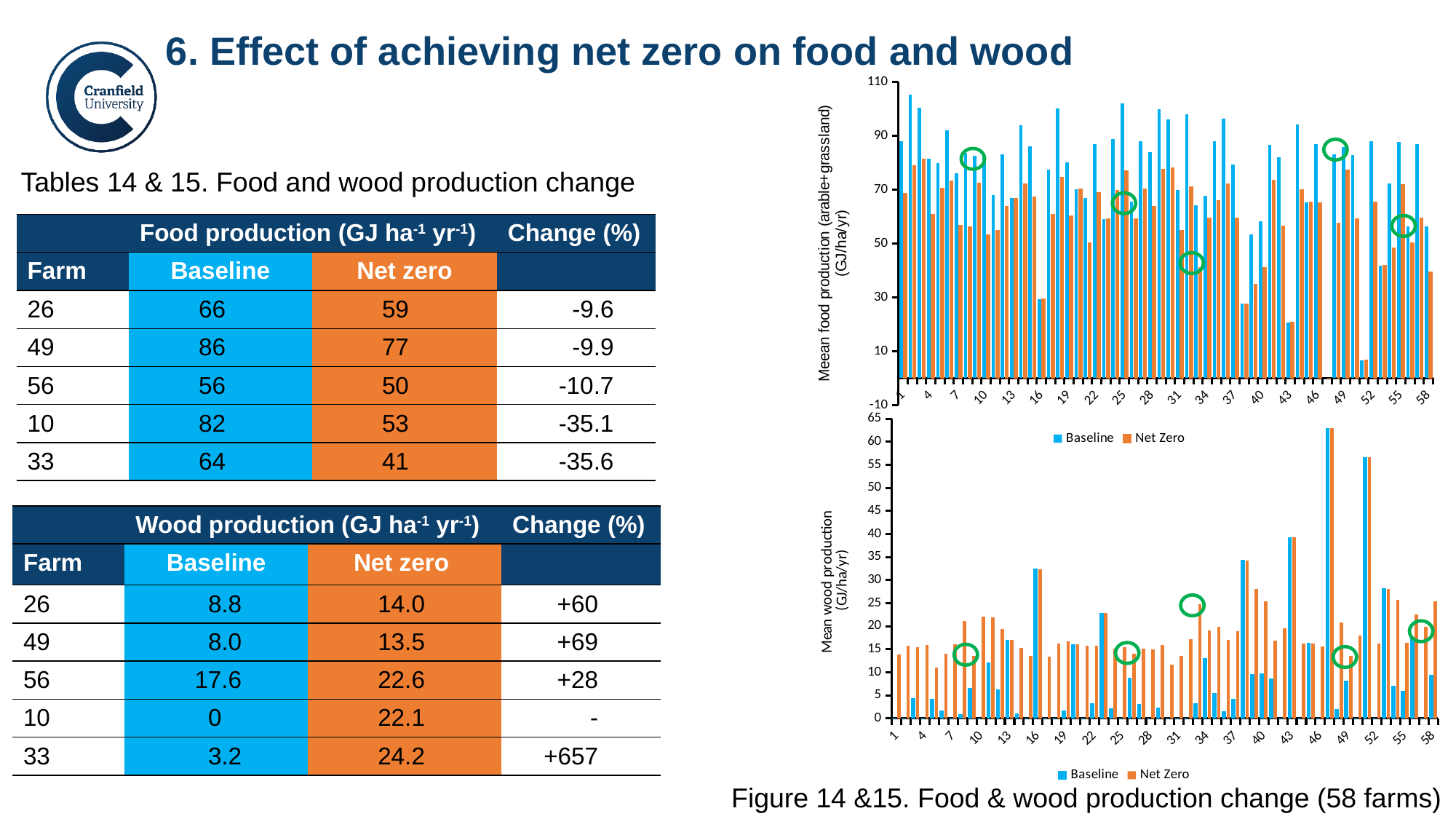
In the bottom chart (mean wood production), is the Baseline value for farm 47 greater or less than 50? greater What kind of chart is the top chart (mean food production)? bar chart In the top chart (mean food production), is the Baseline value for farm 1 greater or less than 70? greater In the top chart (mean food production), is the Net Zero value for farm 16 greater or less than 50? less What are the two legend entries of the top chart (mean food production)? Baseline and Net Zero In the bottom chart (mean wood production), which is larger, the Baseline value for farm 47 or the Baseline value for farm 52? farm 47 How many series does the legend of the bottom chart (mean wood production) list? 2 In the bottom chart (mean wood production), which farm has the highest Baseline value? 47 According to the figure caption, how many farms are plotted in the charts? 58 In the top chart (mean food production), which is larger for farm 16, the Baseline or the Net Zero value? Neither; they are equal What is the y-axis title of the bottom chart? Mean wood production (GJ/ha/yr)